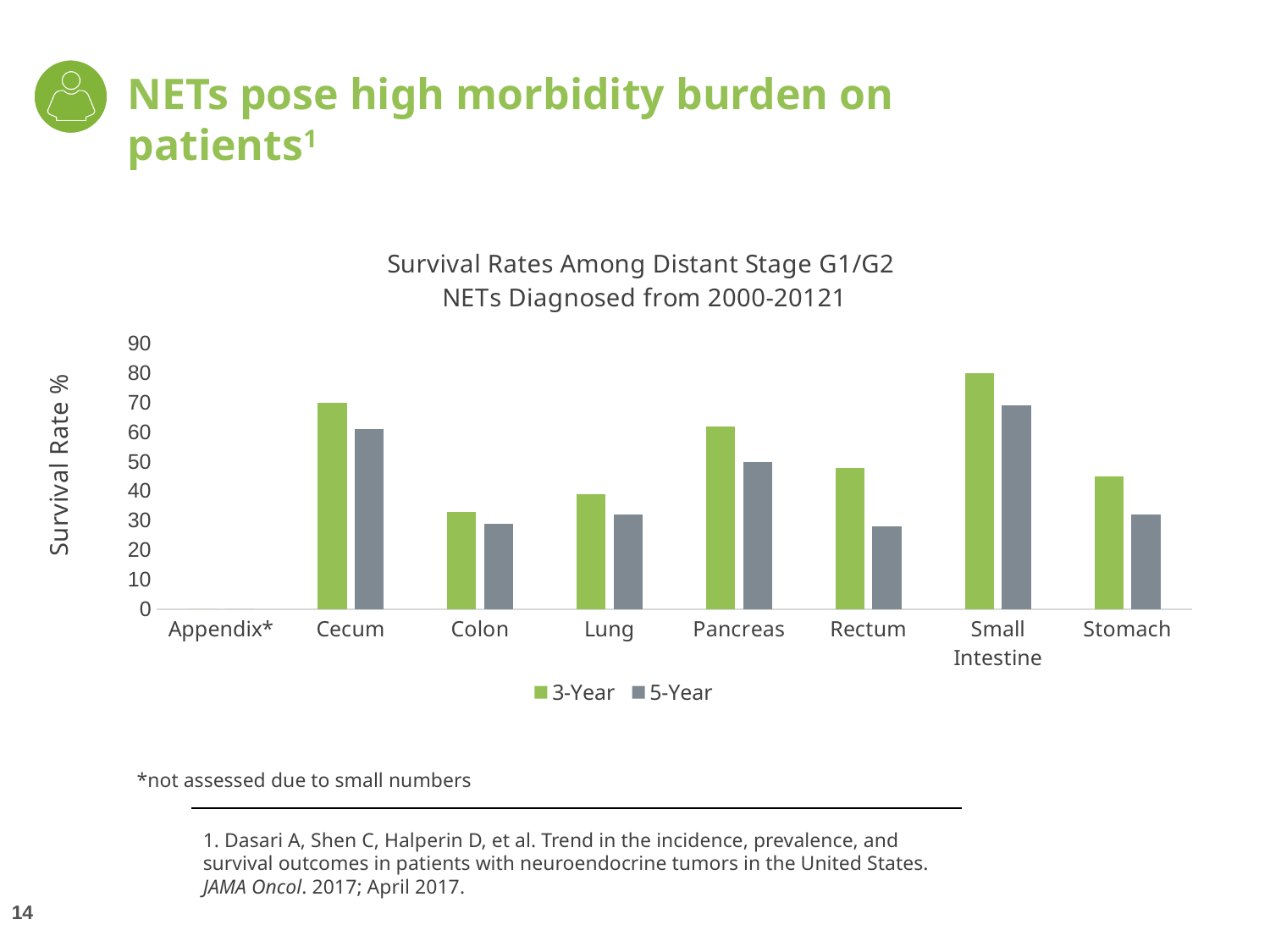
Which category has the highest 5-Year survival rate? Small Intestine Is the 5-Year survival rate for Rectum greater or less than 30? less Among the categories with plotted bars, which has the lowest 3-Year survival rate? Colon Is the 3-Year survival rate for Stomach greater or less than 40? greater What kind of chart is shown on the slide? Bar chart Which category has the highest 3-Year survival rate? Small Intestine Is the 3-Year survival rate for Colon greater or less than 40? less Which is larger, the 3-Year survival rate for Cecum or for Stomach? Cecum What is the 3-Year survival rate for Small Intestine? 80 How many categories are shown on the x axis? 8 Which category has no bars plotted because it was not assessed due to small numbers? Appendix* How many series does the legend list? 2